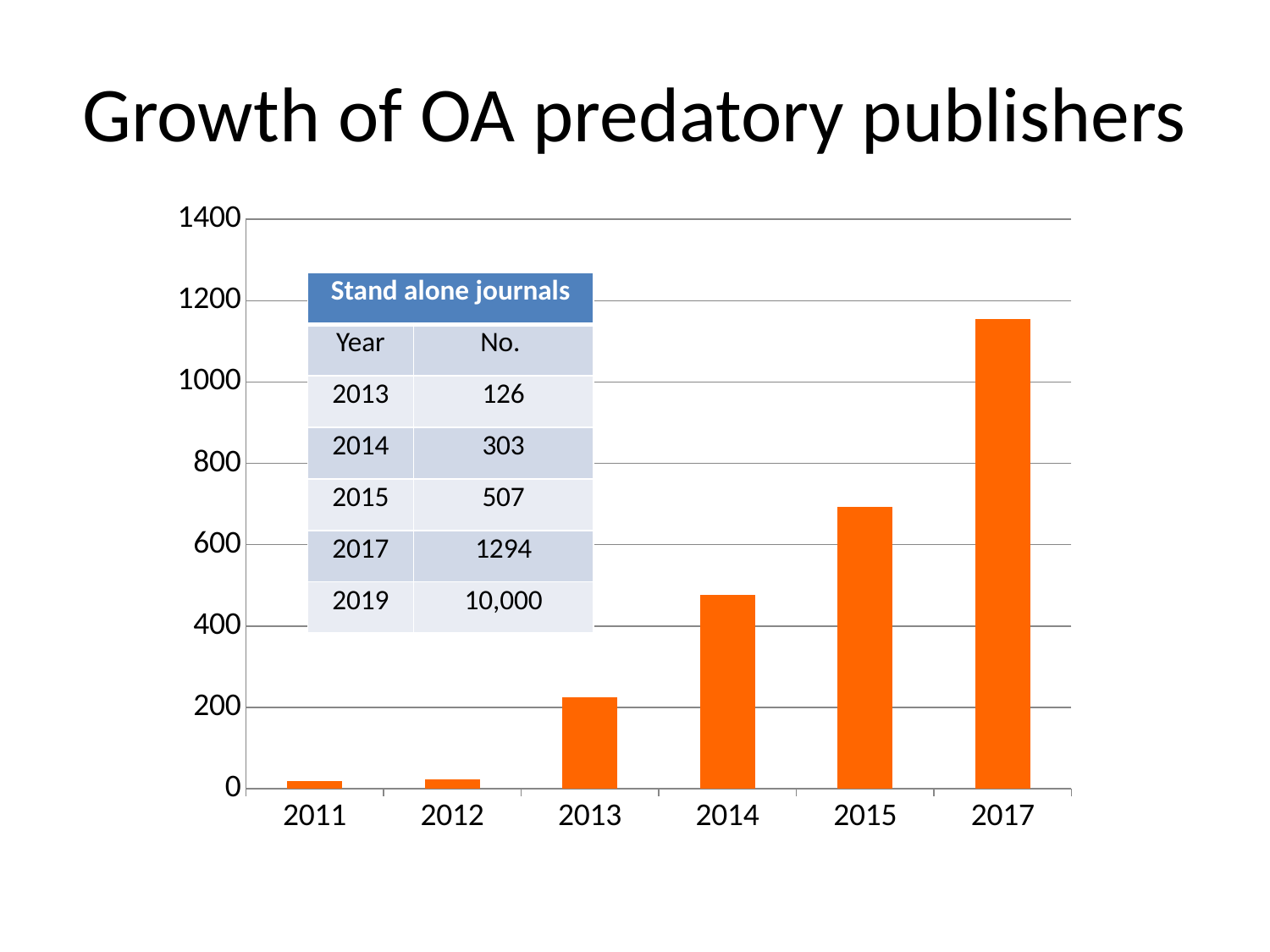
Which year has the highest bar in the chart? 2017 Do the values rise or fall from 2011 to 2017 along the x axis? rise What colour are the bars in the chart? orange Is the value for 2015 greater or less than 800? less What is the title of the slide containing the chart? Growth of OA predatory publishers How many years are shown on the x axis of the chart? 6 Which year has the lowest bar in the chart? 2011 Is the value for 2011 greater or less than 200? less Is the value for 2014 greater or less than 400? greater Which is larger, the value for 2014 or the value for 2015? 2015 What kind of chart is shown on the slide? bar chart